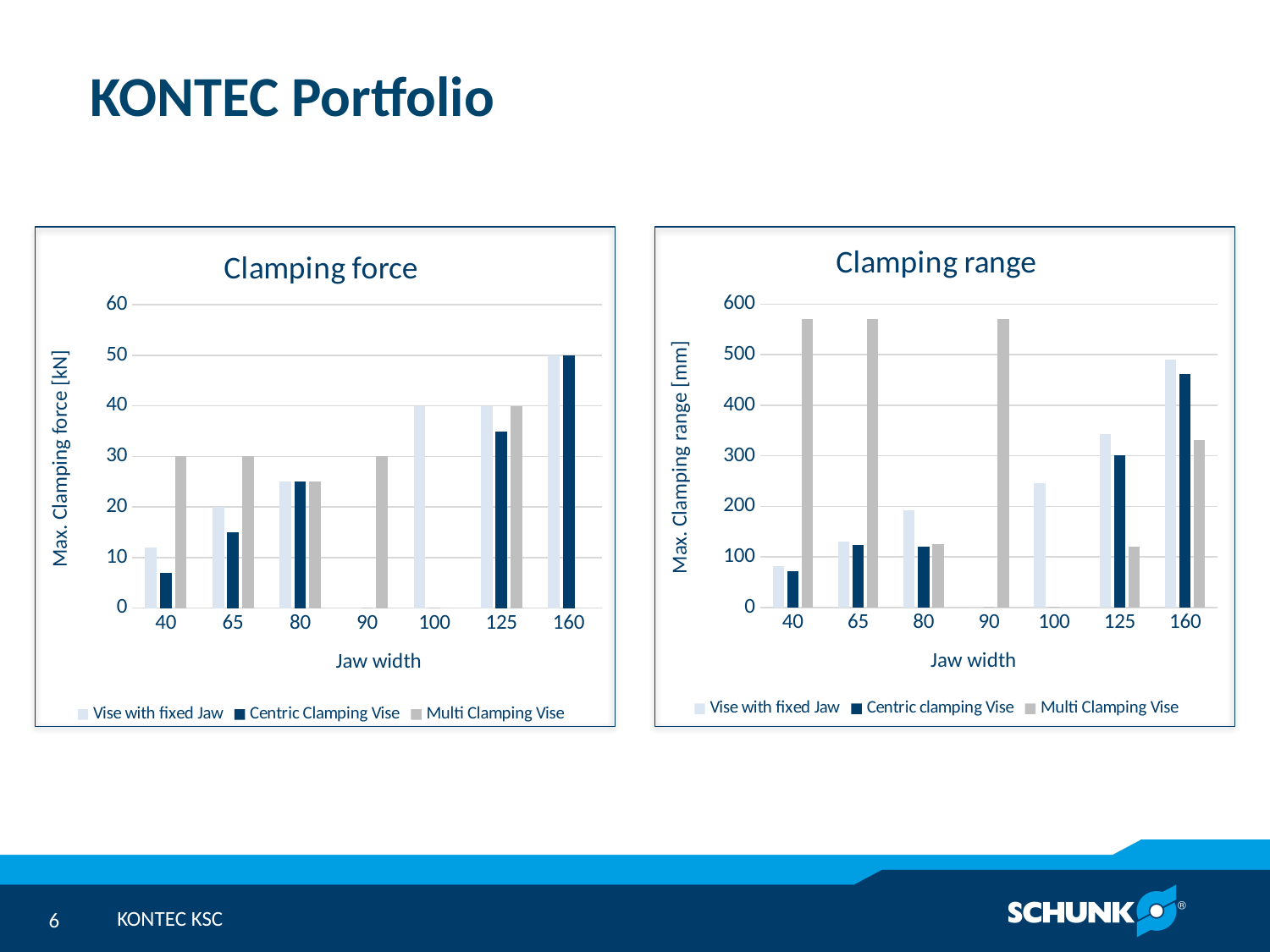
How many jaw width categories are shown on the x axis of the Clamping force chart? 7 In the Clamping range chart, is the value for Multi Clamping Vise at jaw width 40 greater or less than 500? greater What type of chart is the Clamping force chart? bar chart What is the y-axis label of the Clamping range chart? Max. Clamping range [mm] In the Clamping force chart, what is the value for Multi Clamping Vise at jaw width 90? 30 In the Clamping force chart, which jaw width has the highest value for Vise with fixed Jaw? 160 In the Clamping force chart, what is the value for Vise with fixed Jaw at jaw width 100? 40 How many series does the legend of the Clamping range chart list? 3 In the Clamping range chart, which is larger at jaw width 160: Vise with fixed Jaw or Multi Clamping Vise? Vise with fixed Jaw In the Clamping range chart, is the value for Vise with fixed Jaw at jaw width 80 greater or less than 200? less In the Clamping force chart, what is the value for Centric Clamping Vise at jaw width 160? 50